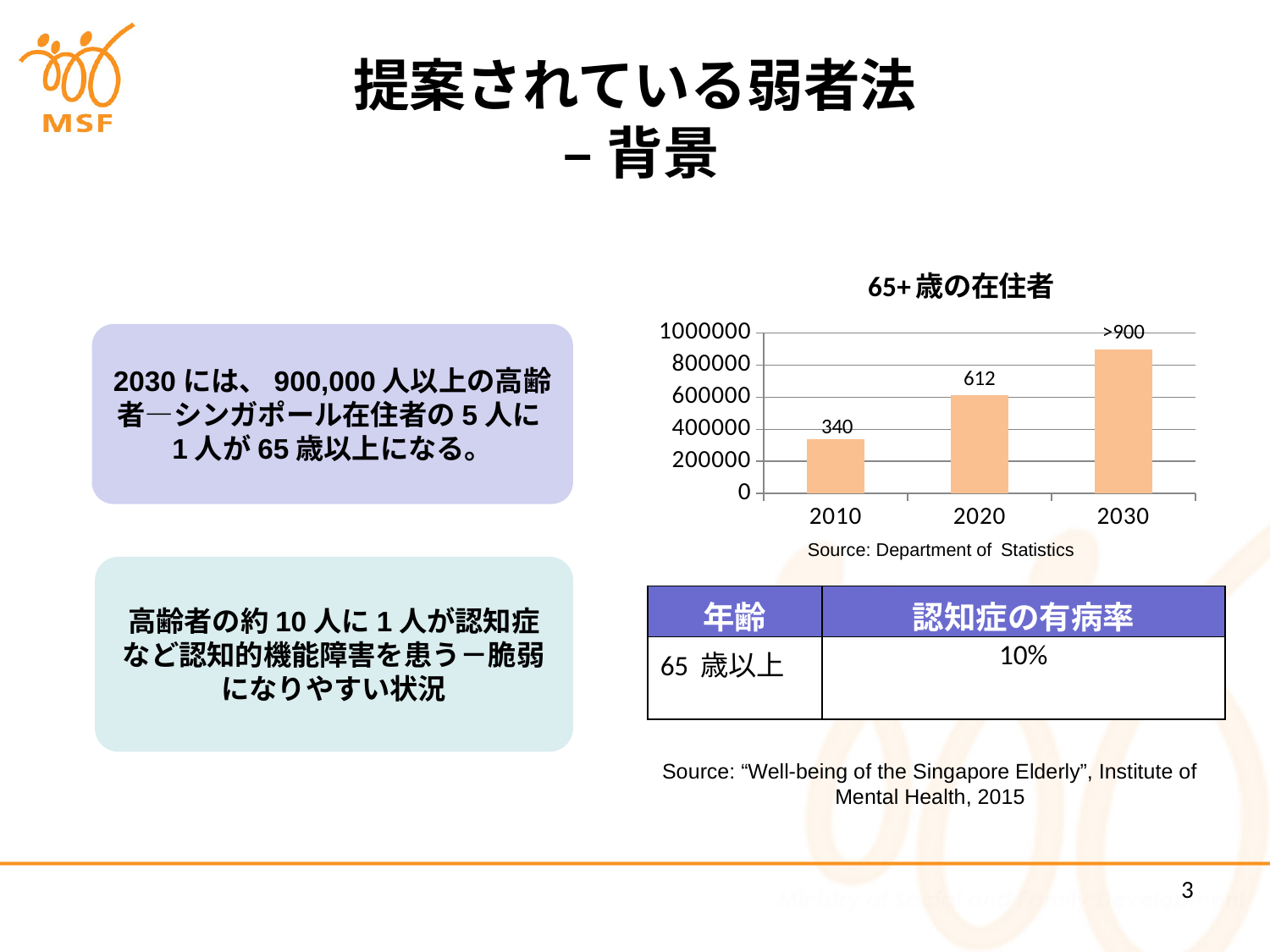
What is the data label for 2030 in the 65+歳の在住者 chart? >900 Is the bar for 2030 in the 65+歳の在住者 chart greater or less than 800000 on the axis? greater What is the data label for 2010 in the 65+歳の在住者 chart? 340 What kind of chart is the 65+歳の在住者 chart? bar chart Which year has the highest bar in the 65+歳の在住者 chart? 2030 Do the values in the 65+歳の在住者 chart rise or fall from 2010 to 2030? rise Is the bar for 2010 in the 65+歳の在住者 chart greater or less than 400000 on the axis? less Which is larger in the 65+歳の在住者 chart, the value for 2010 or the value for 2020? 2020 How many years are shown on the x axis of the 65+歳の在住者 chart? 3 Which year has the lowest bar in the 65+歳の在住者 chart? 2010 What is the data label for 2020 in the 65+歳の在住者 chart? 612 What is the difference between the labelled values for 2020 and 2010 in the 65+歳の在住者 chart? 272